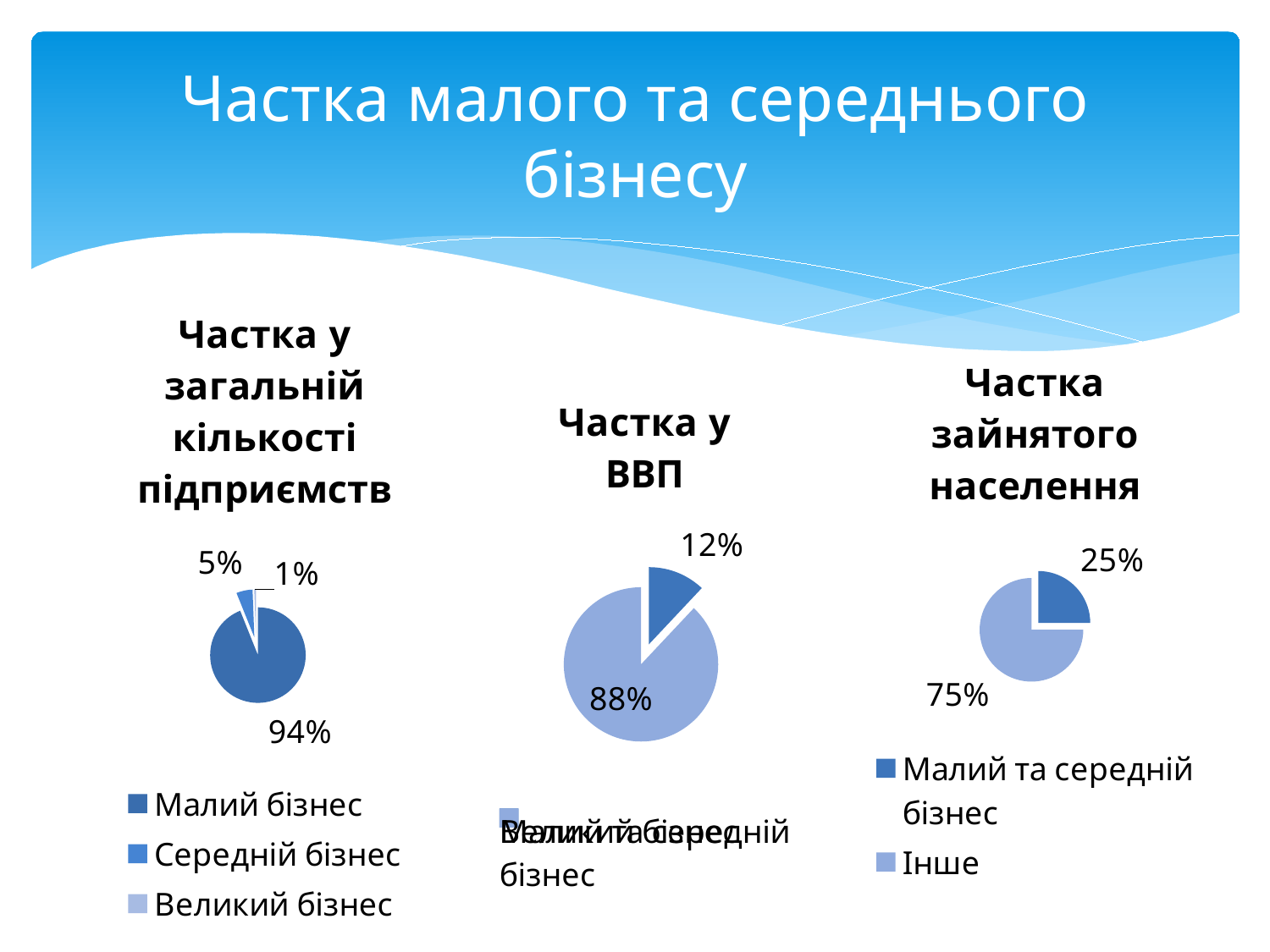
In the chart titled "Частка у загальній кількості підприємств", how many categories does the legend list? 3 In the chart titled "Частка зайнятого населення", what is the share for "Інше"? 75% In the chart titled "Частка у загальній кількості підприємств", what is the share for "Середній бізнес"? 5% In the chart titled "Частка зайнятого населення", which category is larger, "Малий та середній бізнес" or "Інше"? Інше In the chart titled "Частка у загальній кількості підприємств", which category has the smallest share? Великий бізнес In the chart titled "Частка у загальній кількості підприємств", what is the difference between the shares of "Малий бізнес" and "Середній бізнес"? 89% In the chart titled "Частка зайнятого населення", what is the share for "Малий та середній бізнес"? 25% In the chart titled "Частка у ВВП", what is the largest slice's value? 88% In the chart titled "Частка у ВВП", how many slices does the pie have? 2 In the chart titled "Частка у загальній кількості підприємств", what is the share for "Великий бізнес"? 1% What type of chart is used for "Частка зайнятого населення"? Pie chart In the chart titled "Частка у загальній кількості підприємств", what is the share for "Малий бізнес"? 94%